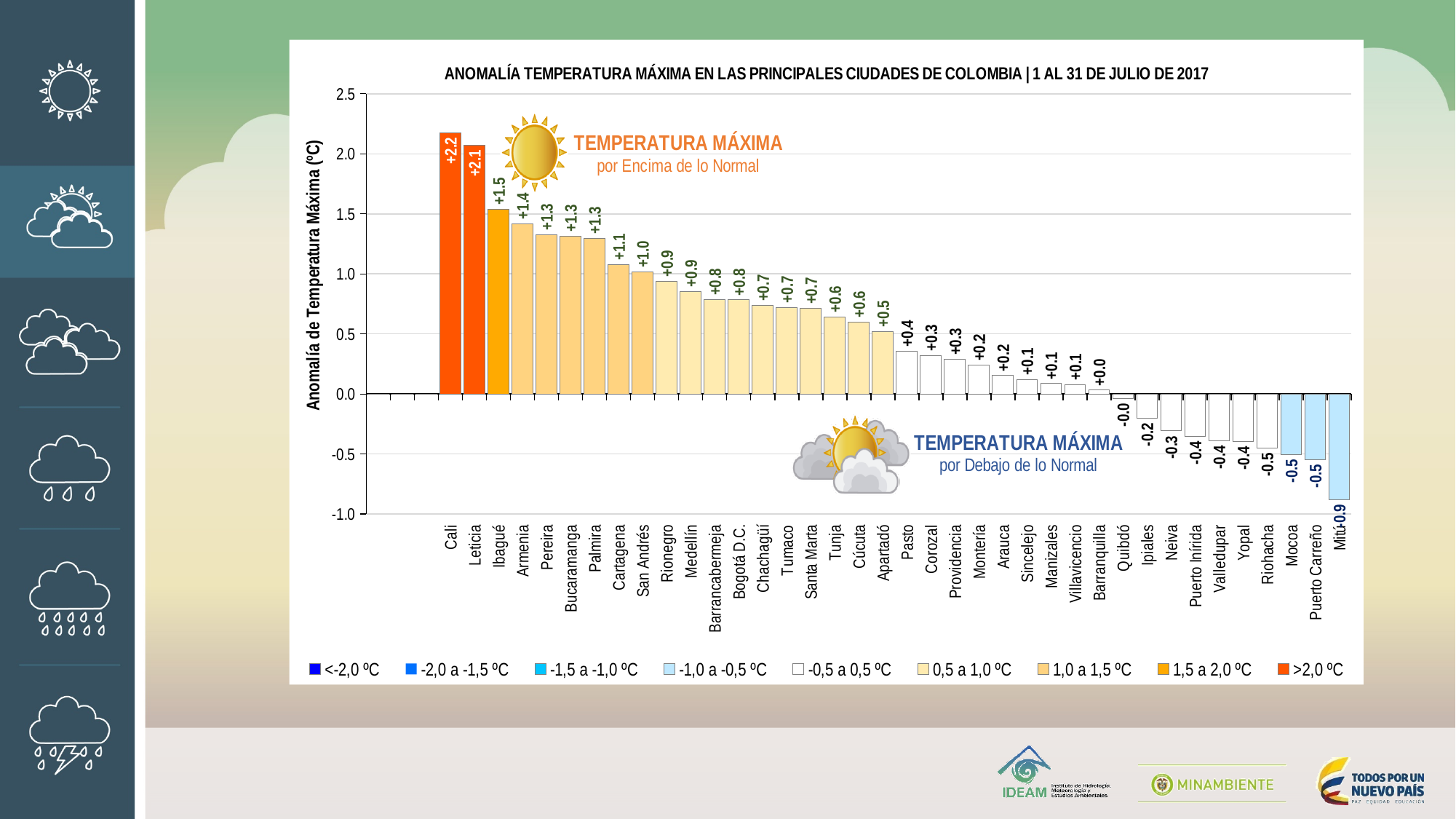
What is the maximum temperature anomaly shown for Mitú? -0.9 What is the maximum temperature anomaly shown for Cali? +2.2 How many temperature ranges does the legend list? 9 How many cities are shown on the chart? 38 What is the maximum temperature anomaly shown for Bogotá D.C.? +0.8 Do the anomaly values rise or fall from left to right along the x axis? Fall Which city has the highest maximum temperature anomaly? Cali Which has a larger anomaly, Cartagena or Medellín? Cartagena What is the difference between the anomaly for Cali and the anomaly for Leticia? 0.1 Which city has the lowest maximum temperature anomaly? Mitú Is the anomaly for Ibagué greater or less than 1.0? greater What kind of chart is shown on the slide? Bar chart